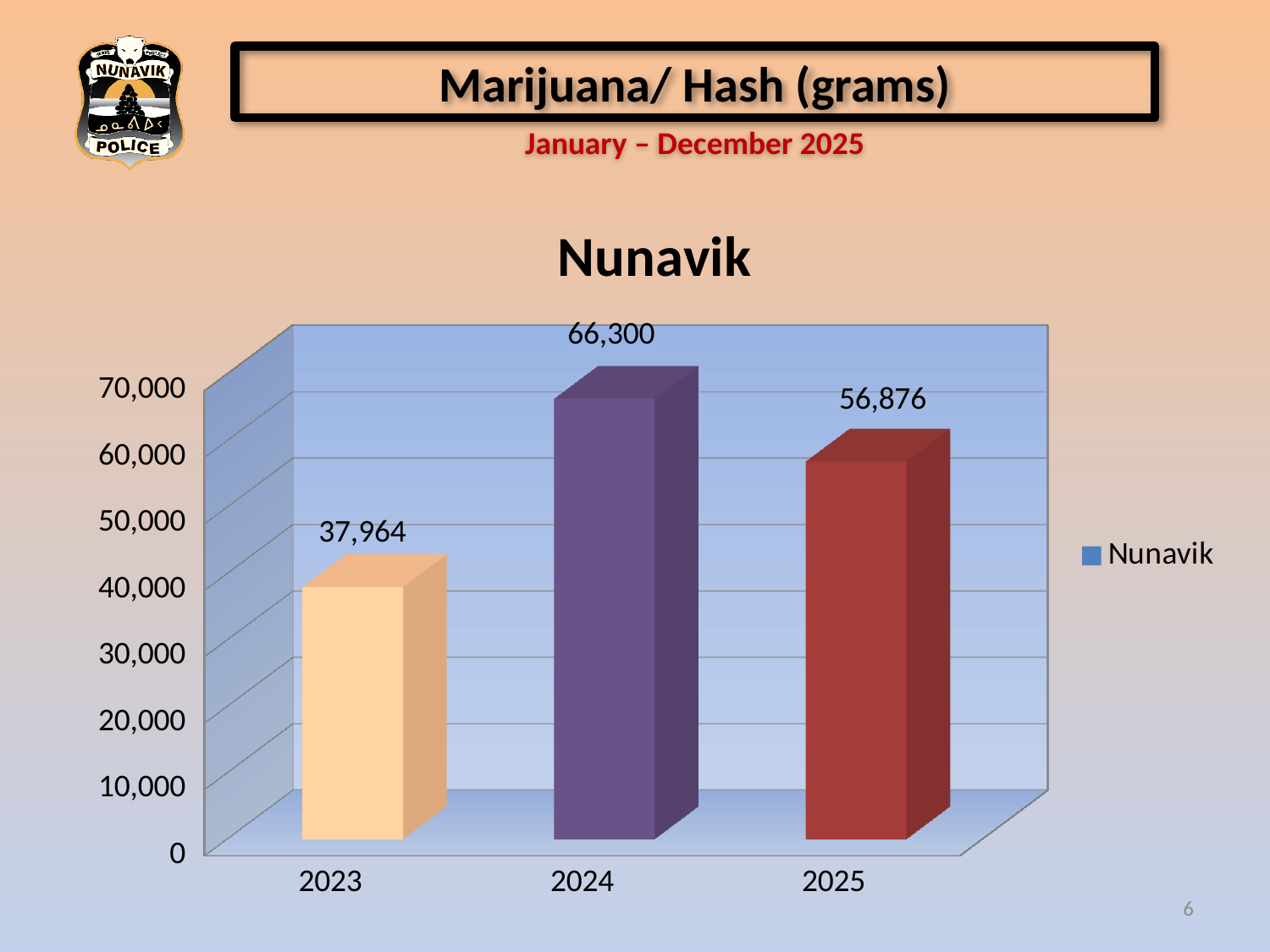
Which year has the lowest value? 2023 What is the difference between the values for 2024 and 2025? 9,424 What is the value for 2024? 66,300 What is the value for 2023? 37,964 What is the difference between the values for 2024 and 2023? 28,336 How many years are shown on the x axis? 3 What is the title of the chart? Nunavik Which is larger, the value for 2025 or the value for 2023? 2025 What kind of chart is shown? bar chart How many series does the legend list? 1 Which year has the highest value? 2024 What is the value for 2025? 56,876